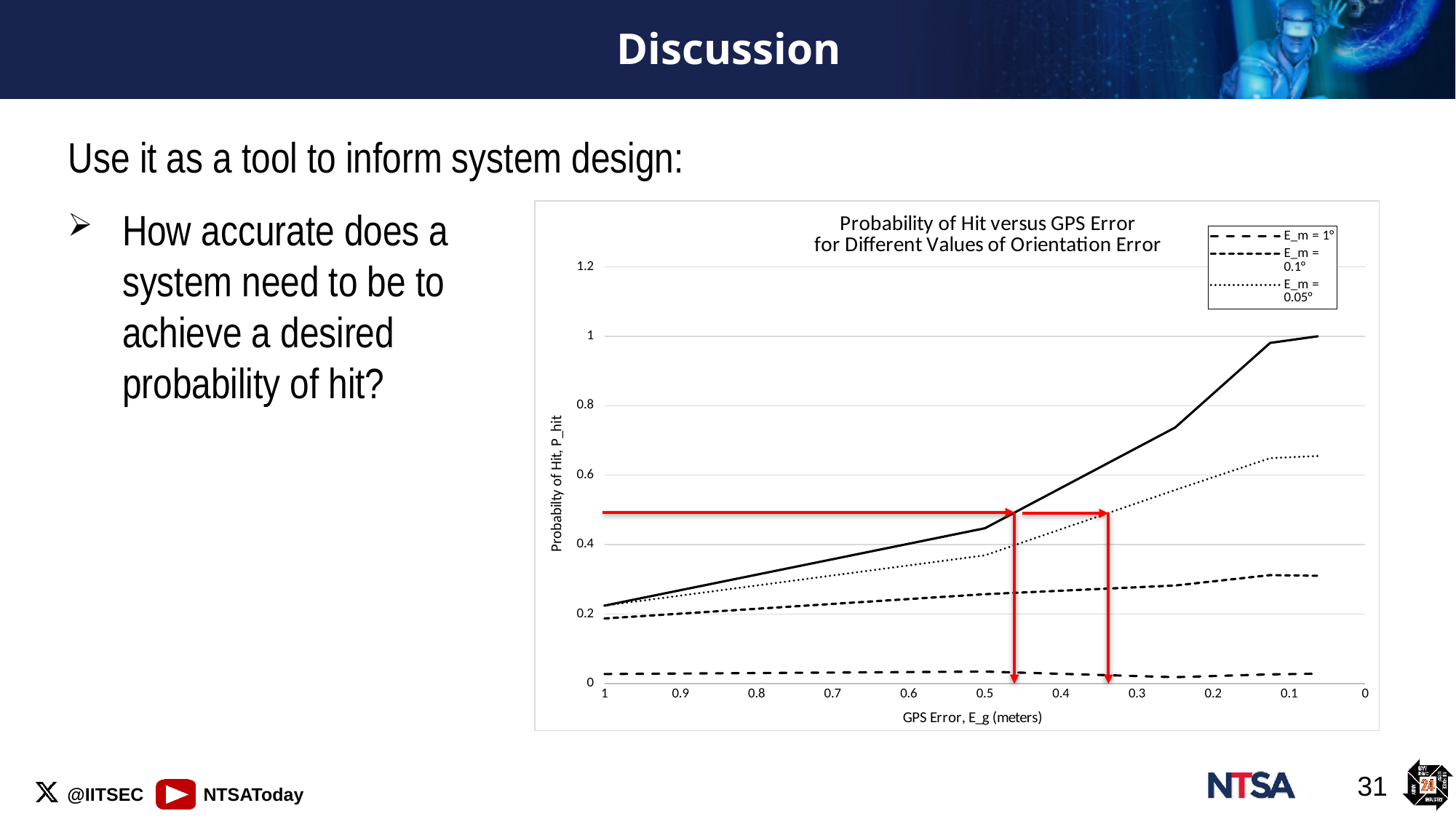
Is the value of the E_m = 0.05° series at a GPS error of 0.1 meters greater or less than 0.4? greater At a GPS error of 0.5 meters, which series has the higher probability of hit: E_m = 0.1° or E_m = 1°? E_m = 0.1° What is the label of the chart's x axis? GPS Error, E_g (meters) Which series listed in the legend has the lowest probability of hit across the whole chart? E_m = 1° What kind of chart is shown on the slide? line chart What is the title of the chart? Probability of Hit versus GPS Error for Different Values of Orientation Error Of the three series listed in the legend, which has the highest probability of hit at a GPS error of 0.1 meters? E_m = 0.05° How many series does the chart's legend list? 3 Is the value of the E_m = 1° series at a GPS error of 0.5 meters greater or less than 0.2? less Is the value of the E_m = 0.1° series at a GPS error of 0.1 meters greater or less than 0.4? less Moving from left to right along the x axis, does the solid line rise or fall? rise How many tick labels are shown on the x axis of the chart? 11